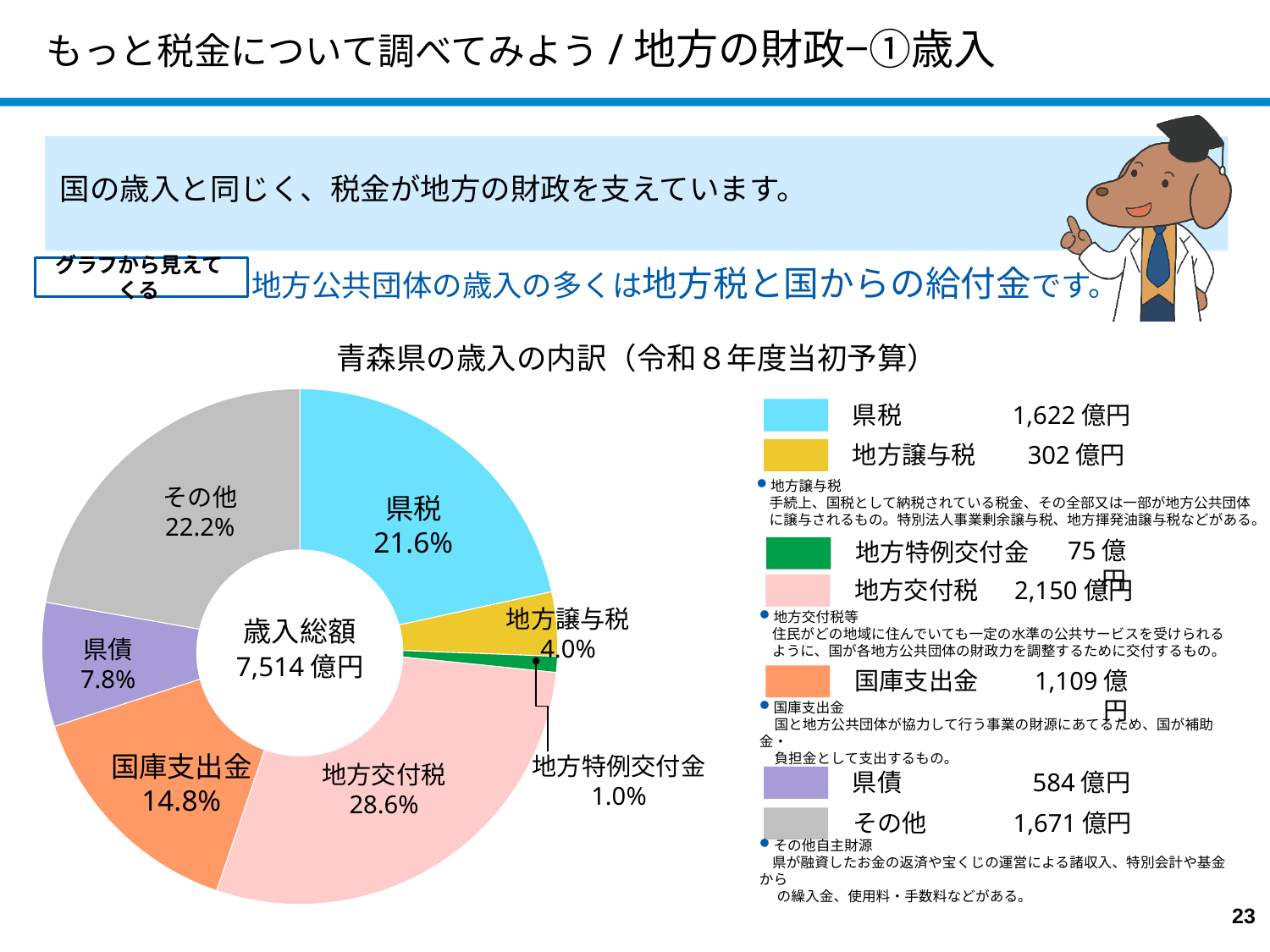
青森県の歳入の内訳のグラフで、最も割合が大きい項目はどれですか？ 地方交付税 青森県の歳入の内訳のグラフで、国庫支出金の金額はいくらですか？ 1,109億円 青森県の歳入の内訳のグラフは、どの種類のグラフですか？ 円グラフ（ドーナツグラフ） 青森県の歳入の内訳のグラフには、いくつの項目がありますか？ 7 青森県の歳入の内訳のグラフで、その他と県税の割合の差は何ポイントですか？ 0.6ポイント 青森県の歳入の内訳のグラフで、地方交付税の割合は何%ですか？ 28.6% 青森県の歳入の内訳のグラフで、県税はどの色で示されていますか？ 水色 青森県の歳入の内訳のグラフで、県税の割合は何%ですか？ 21.6% 青森県の歳入の内訳のグラフで、歳入総額はいくらですか？ 7,514億円 青森県の歳入の内訳のグラフで、国庫支出金と県債ではどちらの割合が大きいですか？ 国庫支出金 青森県の歳入の内訳のグラフで、地方交付税と県税の金額の差はいくらですか？ 528億円 青森県の歳入の内訳のグラフで、最も割合が小さい項目はどれですか？ 地方特例交付金